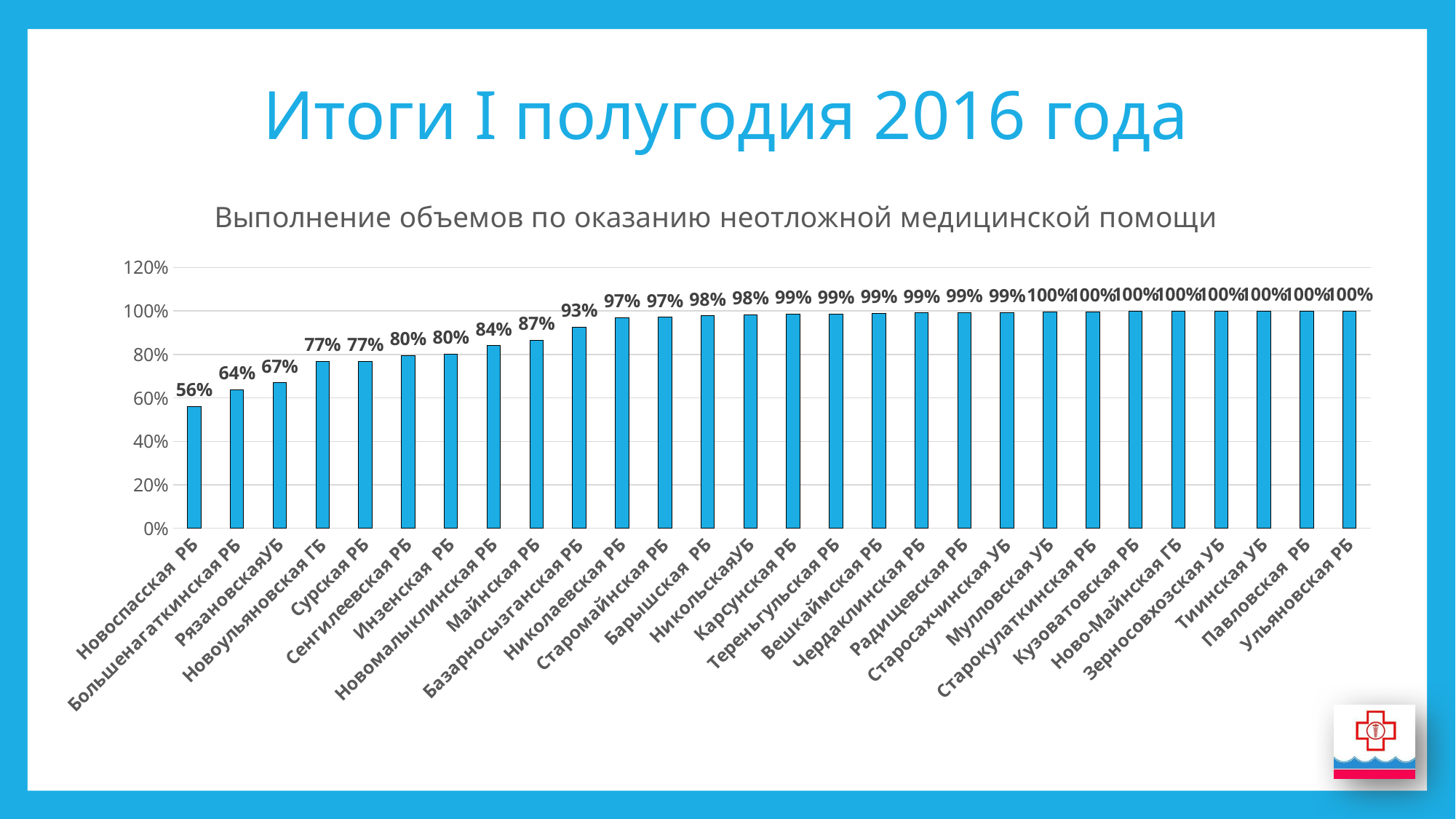
What kind of chart is shown on the slide? bar chart Which is larger, the value for Рязановская УБ or the value for Сурская РБ? Сурская РБ How many categories are shown on the chart? 28 What is the value for Новомалыклинская РБ? 84% Is the value for Инзенская РБ greater or less than 60%? greater What is the difference between the values for Большенагаткинская РБ and Новоспасская РБ? 8% Which category has the lowest value? Новоспасская РБ What is the value for Майнская РБ? 87% What is the difference between the values for Ульяновская РБ and Майнская РБ? 13% What is the value for Новоспасская РБ? 56% What is the value for Базарносызганская РБ? 93% Do the values rise or fall from left to right along the x axis? rise